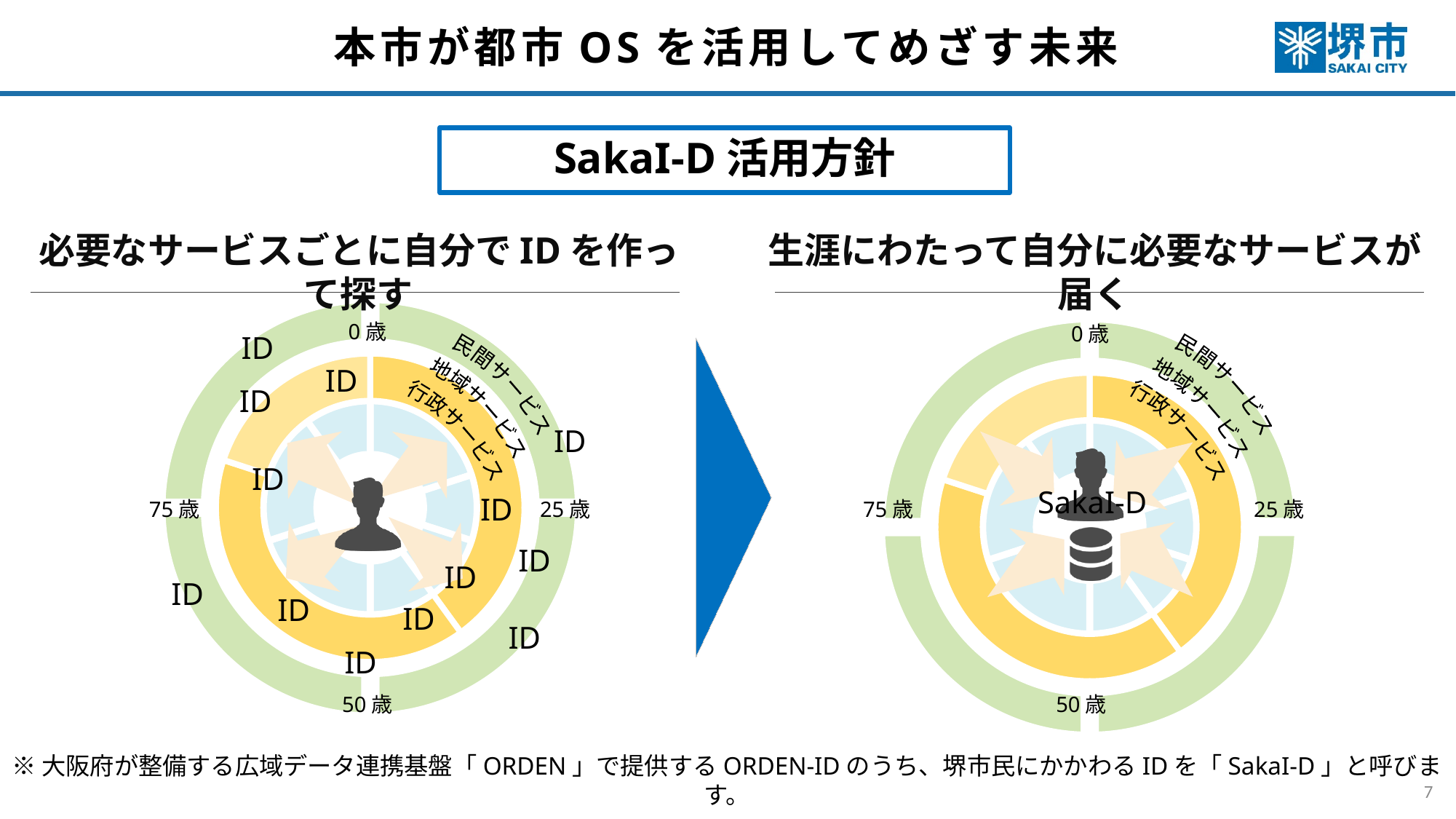
How many service rings (民間サービス, 地域サービス, 行政サービス) are labelled on the right diagram? 3 On the right diagram, what text is written in the centre of the circle? SakaI-D On the left diagram, what age label appears on the left side of the circle? 75歳 On the left diagram, what age label appears at the top of the circle? 0歳 How many age labels (0歳, 25歳, 50歳, 75歳) are placed around the left diagram? 4 On the right diagram, what age label appears at the bottom of the circle? 50歳